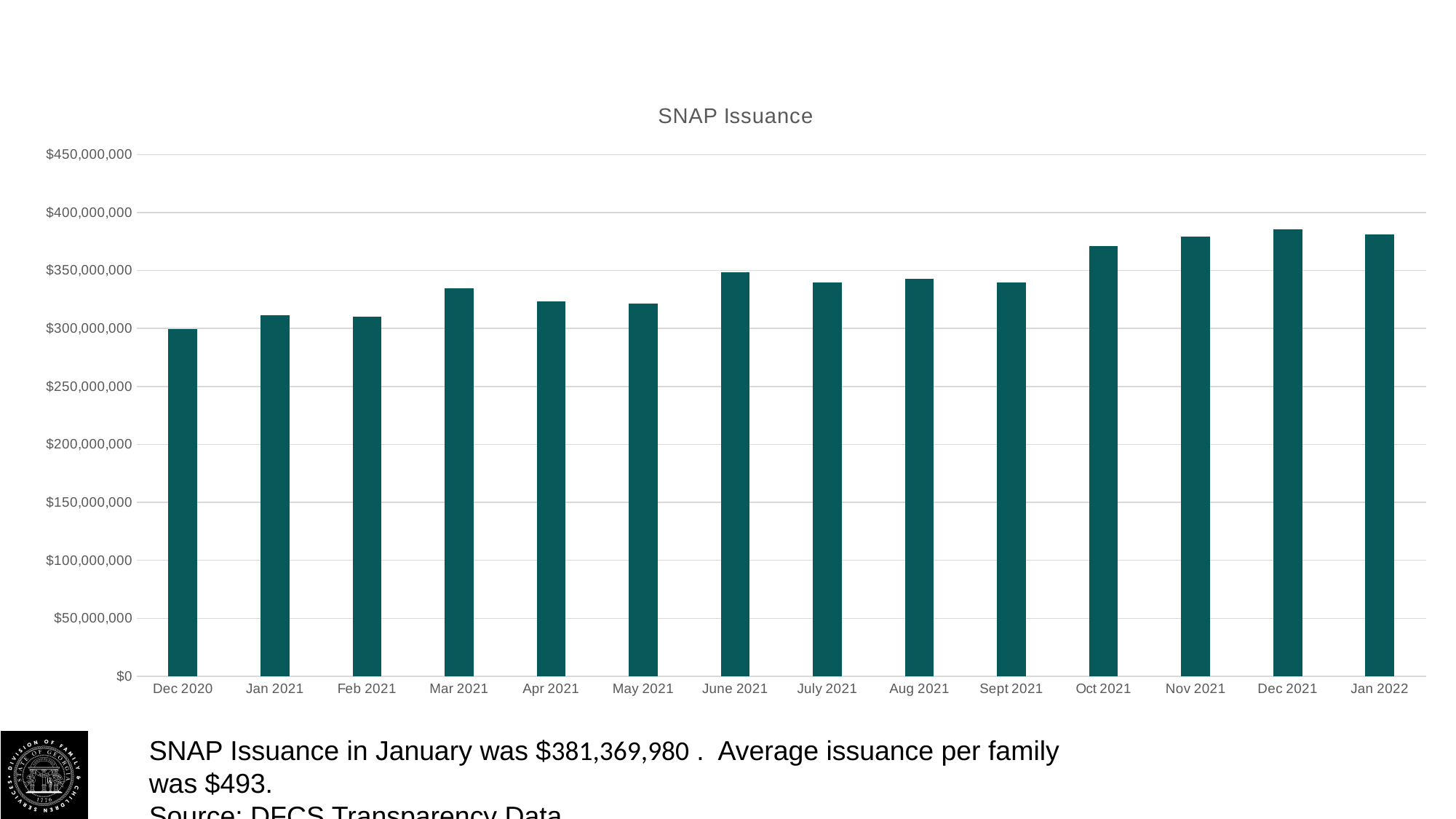
Which is larger, the SNAP issuance for May 2021 or June 2021? June 2021 Is the value for Mar 2021 greater or less than $350,000,000? less Which month has the lowest SNAP issuance in the chart? Dec 2020 How many months are plotted on the x axis of the chart? 14 Is the value for Dec 2021 greater or less than $400,000,000? less What is the title of the chart? SNAP Issuance According to the slide, what was the SNAP issuance in January 2022? $381,369,980 Is the value for Oct 2021 greater or less than $350,000,000? greater Overall, do SNAP issuance values rise or fall from Dec 2020 to Jan 2022? Rise Which is larger, the SNAP issuance for Sept 2021 or Oct 2021? Oct 2021 What type of chart is shown on the slide? Bar chart